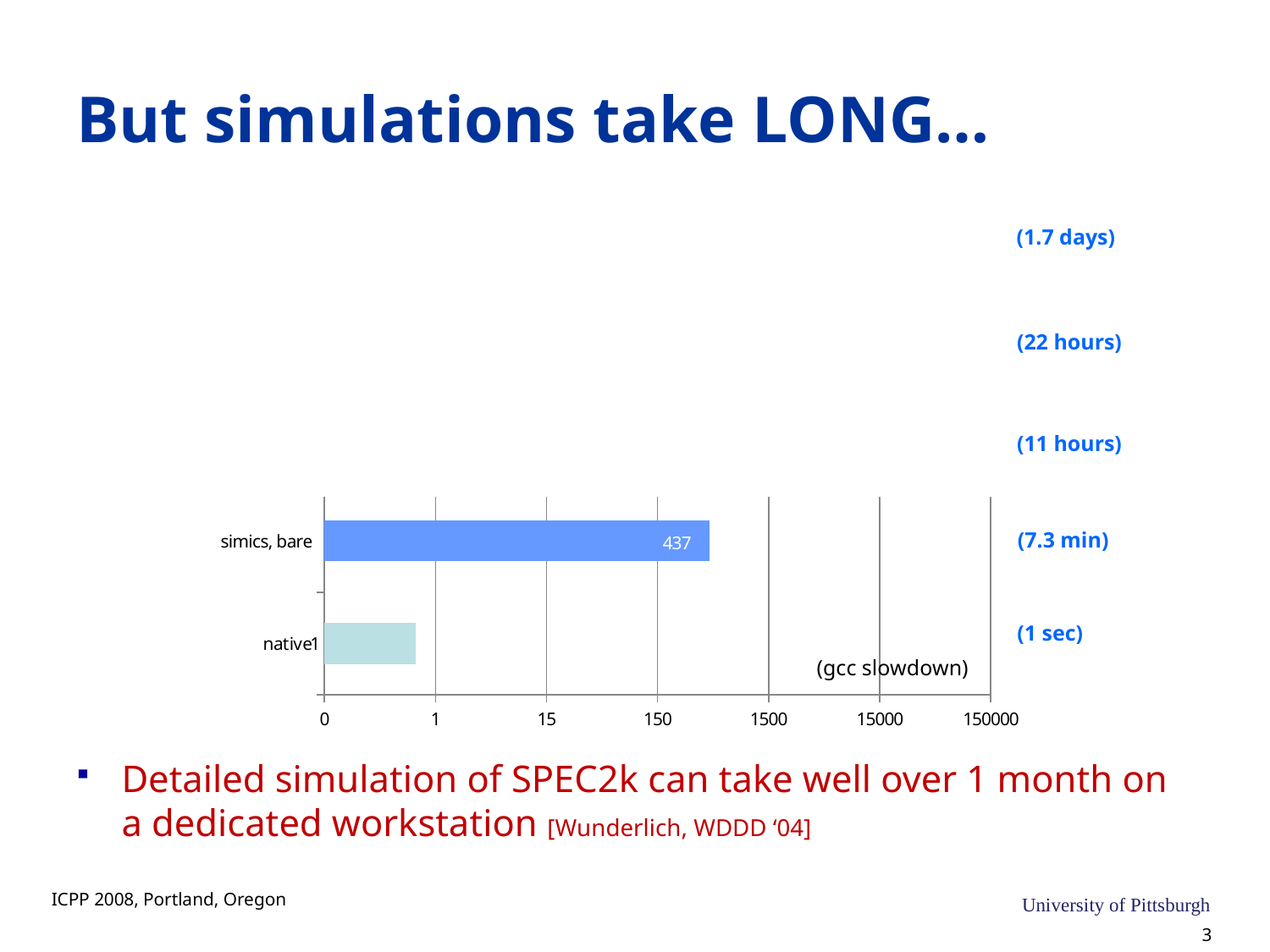
Is the value for "simics, bare" greater or less than 150? greater Is the value for "simics, bare" greater or less than 1500? less What kind of chart is shown on the slide? bar chart What value is shown for the "simics, bare" bar? 437 Which is larger, the value for "simics, bare" or the value for "native1"? simics, bare What is the largest tick value shown on the x axis? 150000 What time annotation is printed to the right of the "simics, bare" bar? (7.3 min) Which category has the shortest bar? native1 How many bars are plotted in the chart? 2 Which category has the longest bar? simics, bare